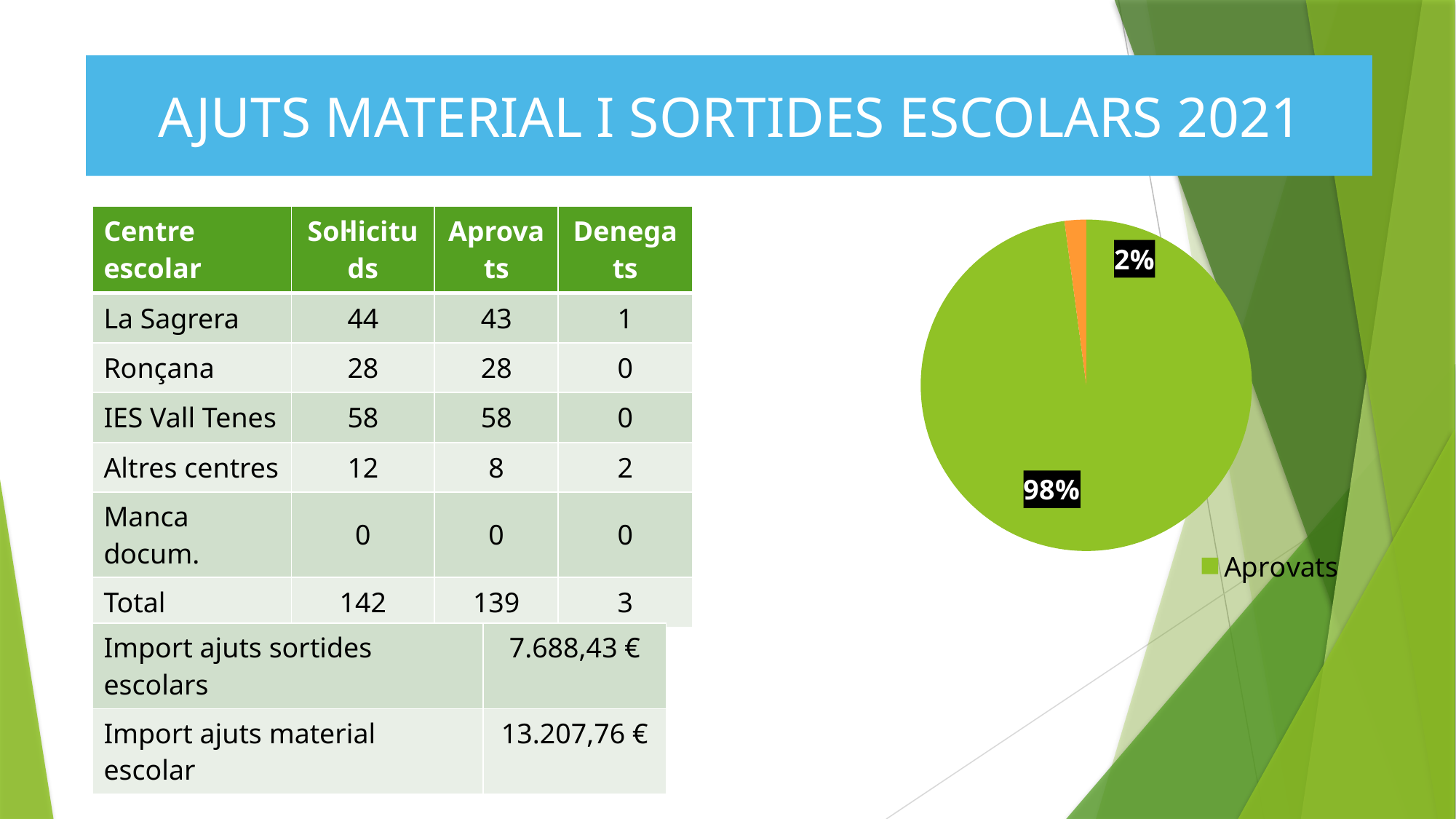
What is the only entry shown in the pie chart's legend? Aprovats Is the Aprovats share in the pie chart greater or less than 50%? greater What share of the pie chart does the Aprovats slice represent? 98% What kind of chart is shown on the slide? pie chart Which slice of the pie chart is the largest? Aprovats How many slices does the pie chart have? 2 What percentage is shown on the small orange slice of the pie chart? 2% Which slice is larger in the pie chart, the green one or the orange one? the green one What is the difference in percentage points between the two slices of the pie chart? 96 What colour is the Aprovats slice in the pie chart? green